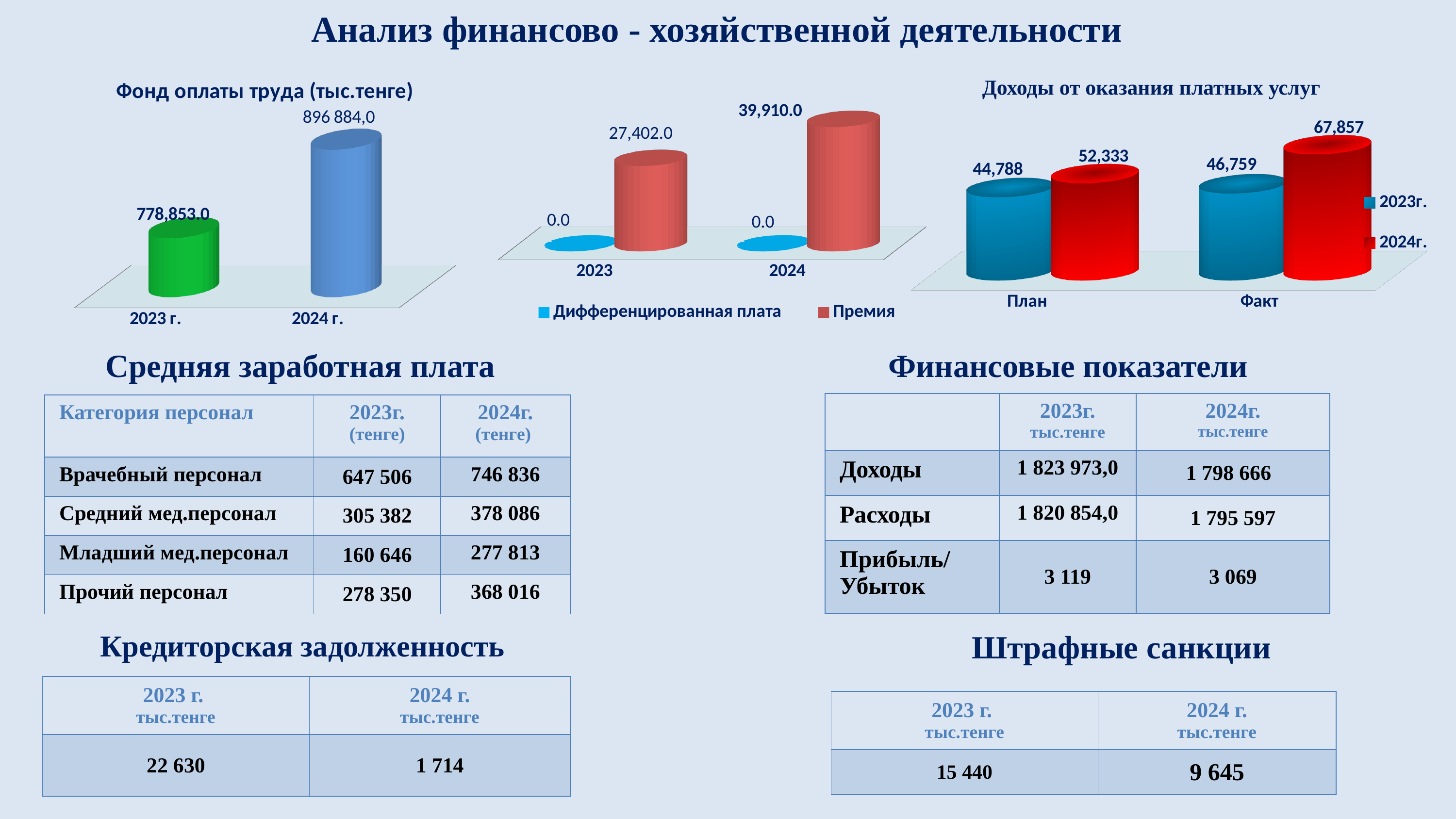
In the middle chart at the top of the slide (with legend 'Дифференцированная плата' and 'Премия'), what is the difference between the Премия values for 2024 and 2023? 12,508.0 In the chart titled 'Доходы от оказания платных услуг', what is the value for Факт in 2024г.? 67,857 In the chart titled 'Фонд оплаты труда (тыс.тенге)', what is the value for 2024 г.? 896 884,0 In the middle chart at the top of the slide (with legend 'Дифференцированная плата' and 'Премия'), what is the value of Премия for 2024? 39,910.0 In the chart titled 'Фонд оплаты труда (тыс.тенге)', which year has the higher value? 2024 г. In the chart titled 'Фонд оплаты труда (тыс.тенге)', what kind of chart is shown? bar chart In the middle chart at the top of the slide (with legend 'Дифференцированная плата' and 'Премия'), how many series does the legend list? 2 In the middle chart at the top of the slide (with legend 'Дифференцированная плата' and 'Премия'), what is the value of Премия for 2023? 27,402.0 In the chart titled 'Фонд оплаты труда (тыс.тенге)', what is the value for 2023 г.? 778,853.0 In the chart titled 'Доходы от оказания платных услуг', what is the value for План in 2023г.? 44,788 In the chart titled 'Доходы от оказания платных услуг', which bar has the lowest value? План 2023г. In the chart titled 'Доходы от оказания платных услуг', what is the difference between the 2024г. and 2023г. values for Факт? 21,098